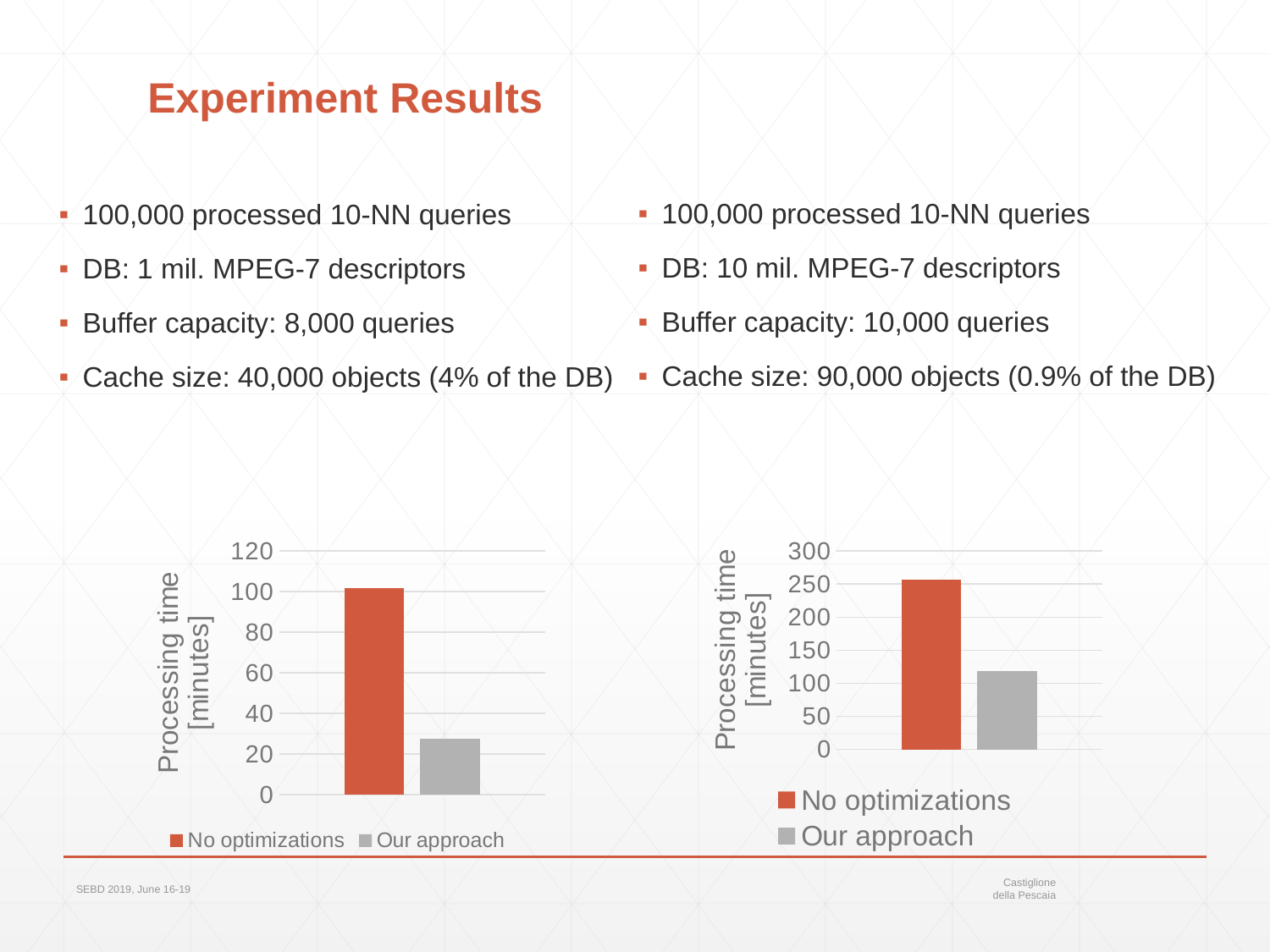
What kind of chart is the right chart on the slide? bar chart In the right chart, is the value for No optimizations greater or less than 200? greater In the left chart, which series has the higher processing time? No optimizations In the right chart, which series has the lower processing time? Our approach In the right chart, how many series does the legend list? 2 In the left chart, is the value for No optimizations greater or less than 80? greater In the left chart, how many series does the legend list? 2 In the left chart, is the value for Our approach greater or less than 40? less In the right chart, what colour is the bar for No optimizations? orange What kind of chart is the left chart on the slide? bar chart What is the y-axis label of the left chart? Processing time [minutes]